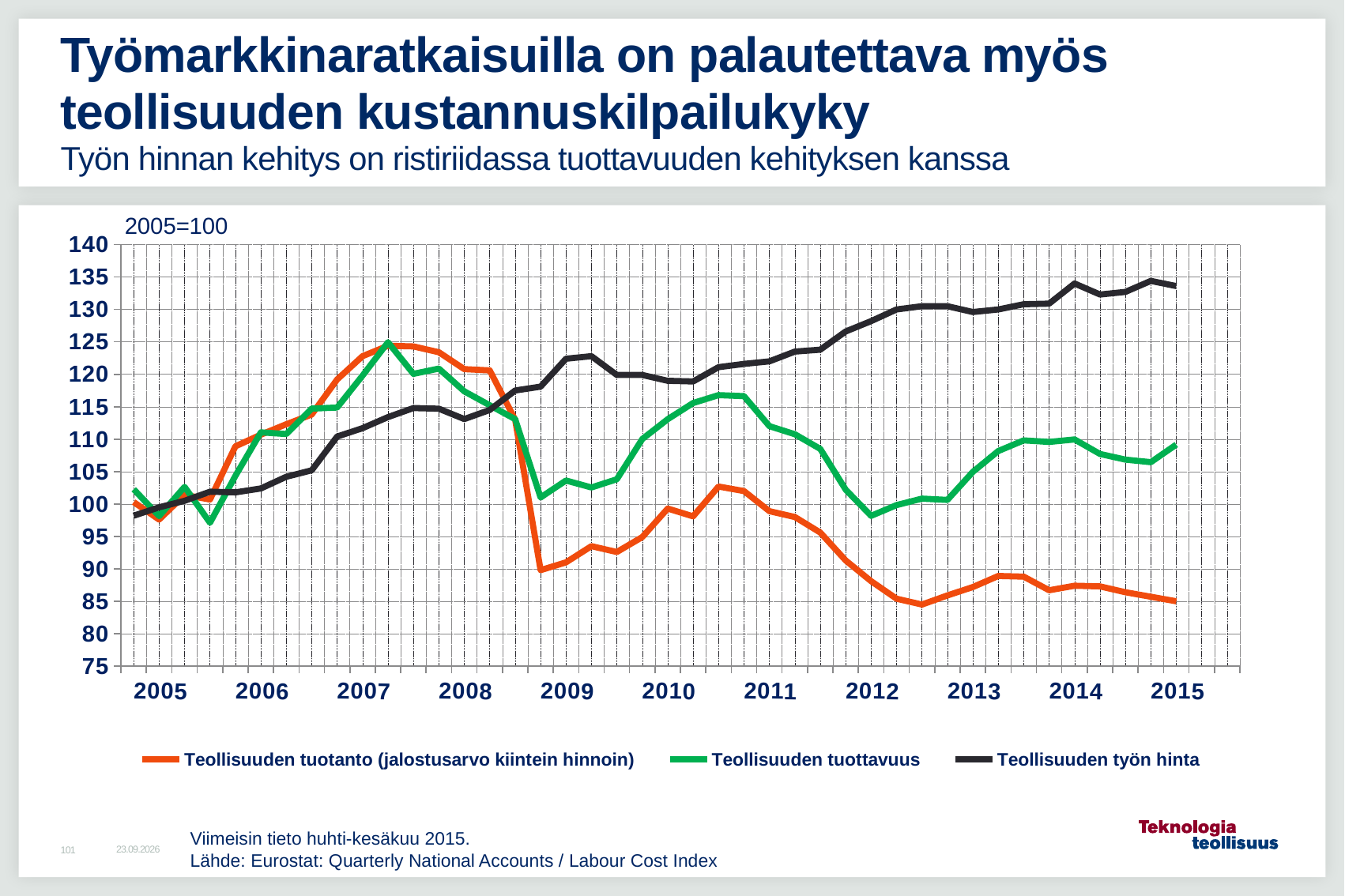
What base-year note is printed above the chart's y axis? 2005=100 How many year labels are shown on the x axis? 11 At 2015, which series has the higher value: Teollisuuden työn hinta or Teollisuuden tuotanto (jalostusarvo kiintein hinnoin)? Teollisuuden työn hinta Does the Teollisuuden työn hinta series rise or fall overall from 2005 to 2015? rise How many series does the legend list? 3 What kind of chart is shown on the slide? line chart Is the value of Teollisuuden tuottavuus at 2015 greater or less than 105? greater Is the value of Teollisuuden tuotanto (jalostusarvo kiintein hinnoin) at 2015 greater or less than 90? less Is the value of Teollisuuden työn hinta at 2015 greater or less than 130? greater Which series has the lowest value at 2015? Teollisuuden tuotanto (jalostusarvo kiintein hinnoin) Which series is drawn with the black line? Teollisuuden työn hinta Does the Teollisuuden tuotanto (jalostusarvo kiintein hinnoin) series rise or fall overall from 2005 to 2015? fall